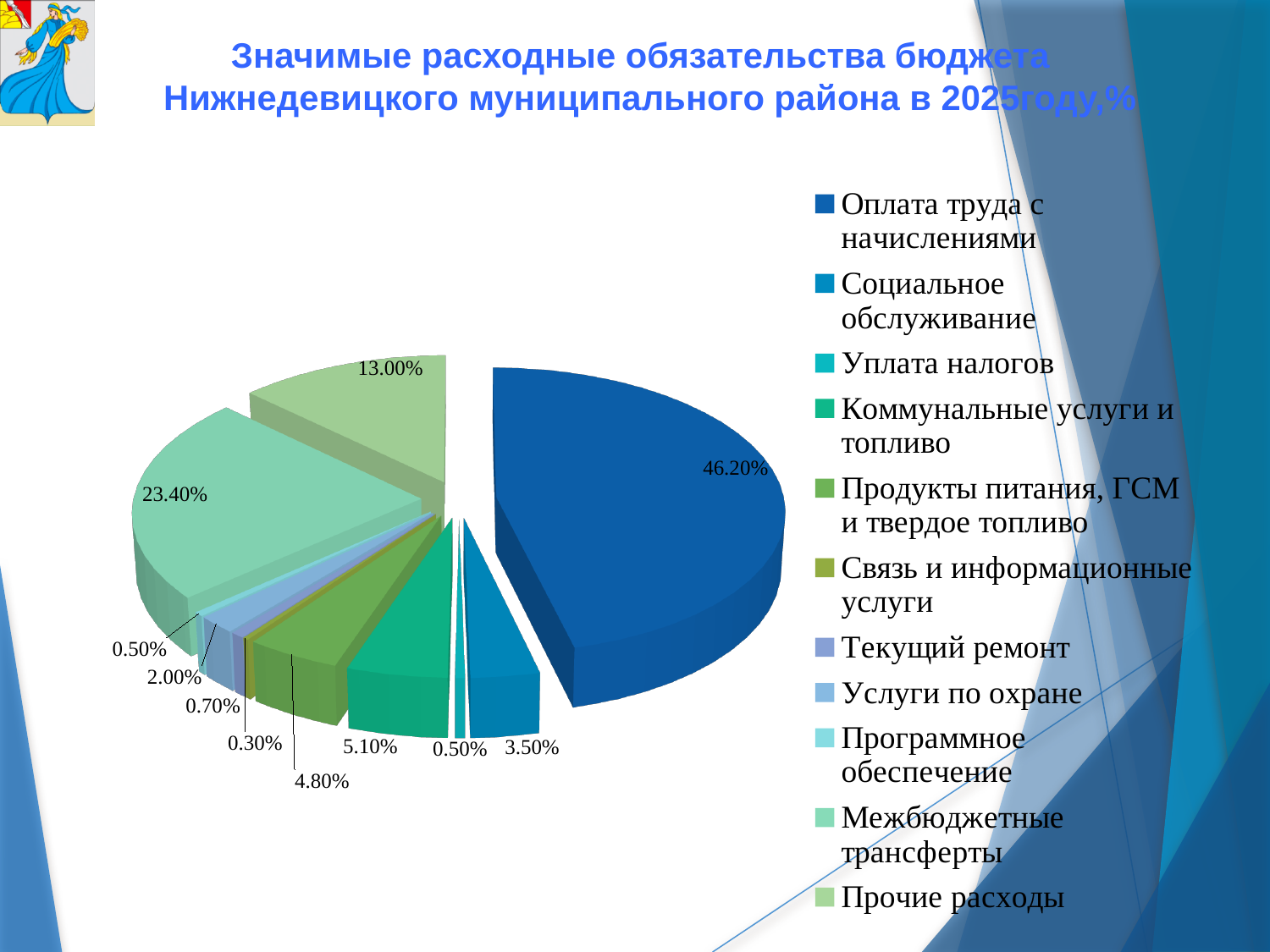
What is the difference in percentage points between Оплата труда с начислениями and Межбюджетные трансферты? 22.80% What share of the pie is labelled for Коммунальные услуги и топливо? 5.10% What share of the pie is labelled for Прочие расходы? 13.00% What share of the pie is labelled for Оплата труда с начислениями? 46.20% How many categories does the pie chart legend list? 11 What kind of chart is shown on the slide? pie chart Which category has the smallest slice of the pie? Связь и информационные услуги What share of the pie is labelled for Социальное обслуживание? 3.50% Which is larger: the slice for Продукты питания, ГСМ и твердое топливо or the slice for Услуги по охране? Продукты питания, ГСМ и твердое топливо What share of the pie is labelled for Межбюджетные трансферты? 23.40% Which year does the chart title say the budget expenditure obligations refer to? 2025 Which category has the largest slice of the pie? Оплата труда с начислениями